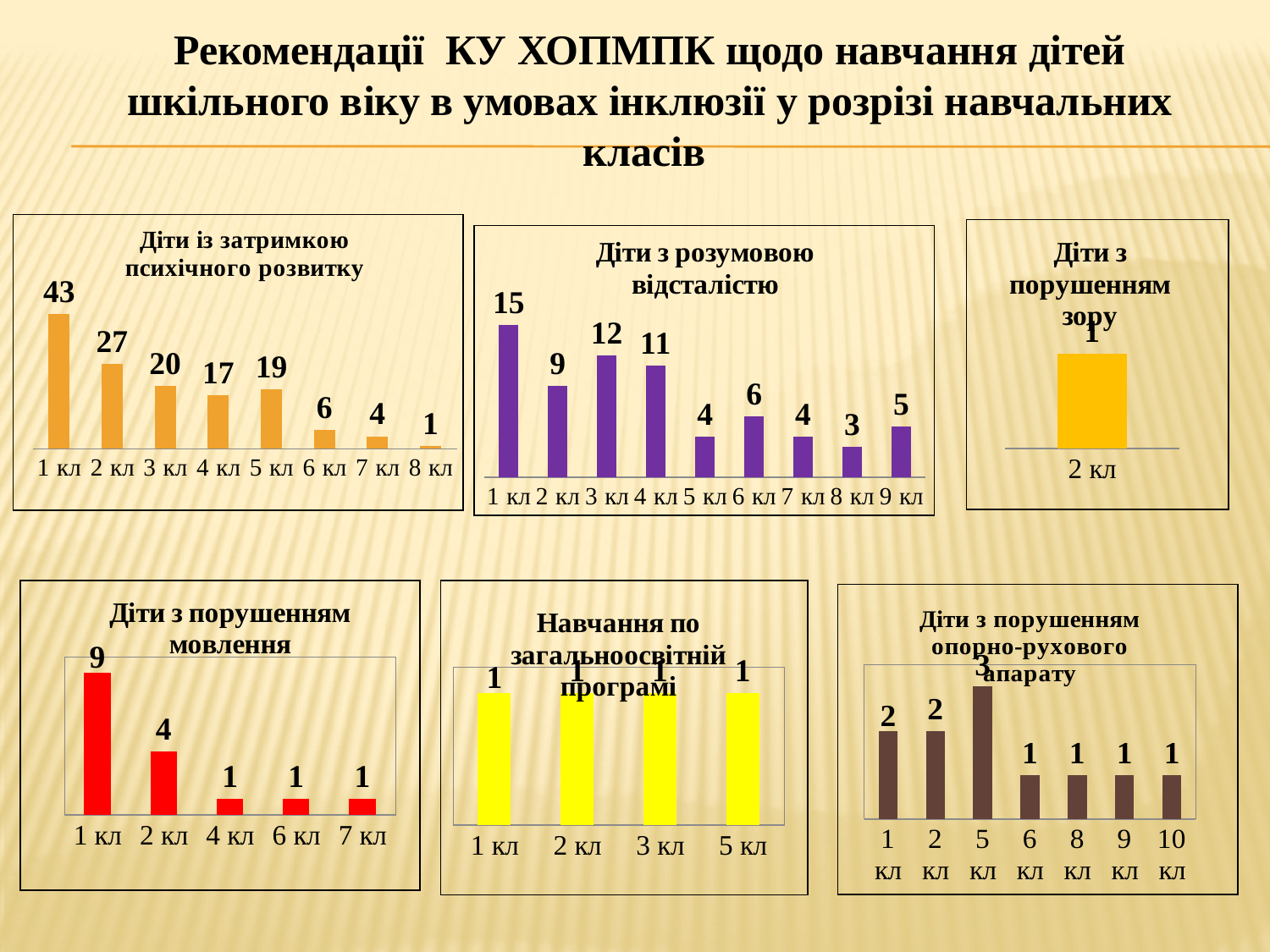
In the chart titled "Діти з порушенням мовлення", what is the value for 2 кл? 4 In the chart titled "Діти із затримкою психічного розвитку", what is the value for 1 кл? 43 In the chart titled "Діти із затримкою психічного розвитку", which class has the lowest value? 8 кл In the chart titled "Діти з розумовою відсталістю", how many classes are shown on the x axis? 9 In the chart titled "Діти з розумовою відсталістю", which class has the highest value? 1 кл In the chart titled "Діти з розумовою відсталістю", what is the value for 4 кл? 11 In the chart titled "Діти з порушенням мовлення", how many classes are shown on the x axis? 5 In the chart titled "Діти з розумовою відсталістю", which is larger, the value for 3 кл or the value for 6 кл? 3 кл In the chart titled "Діти з порушенням зору", what is the value for 2 кл? 1 In the chart titled "Діти з порушенням опорно-рухового апарату", which class has the highest value? 5 кл In the chart titled "Діти із затримкою психічного розвитку", what is the difference between the values for 1 кл and 2 кл? 16 What kind of chart is the one titled "Навчання по загальноосвітній програмі"? Bar chart